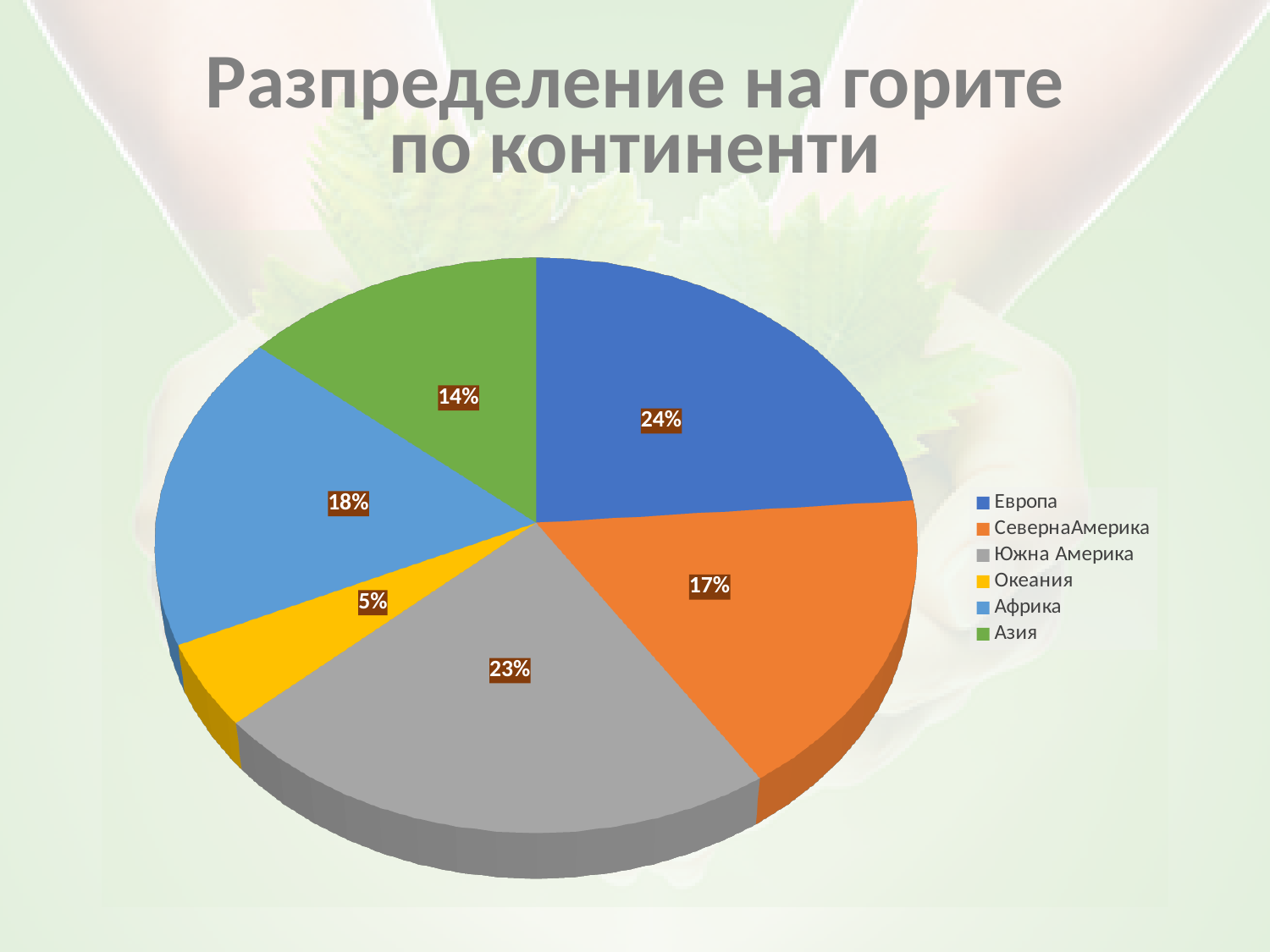
What is the value shown for Африка? 18% How many slices does the pie chart have? 6 Which continent has the largest slice of the pie? Европа What is the difference between the shares of Африка and Азия? 4% What kind of chart is shown on the slide? Pie chart What is the value shown for Океания? 5% What is the title of the chart on the slide? Разпределение на горите по континенти Which is larger, the share for Северна Америка or the share for Африка? Африка What is the value shown for Азия? 14% What is the value shown for Южна Америка? 23% What share of the pie does Европа have? 24% Which continent has the smallest slice of the pie? Океания